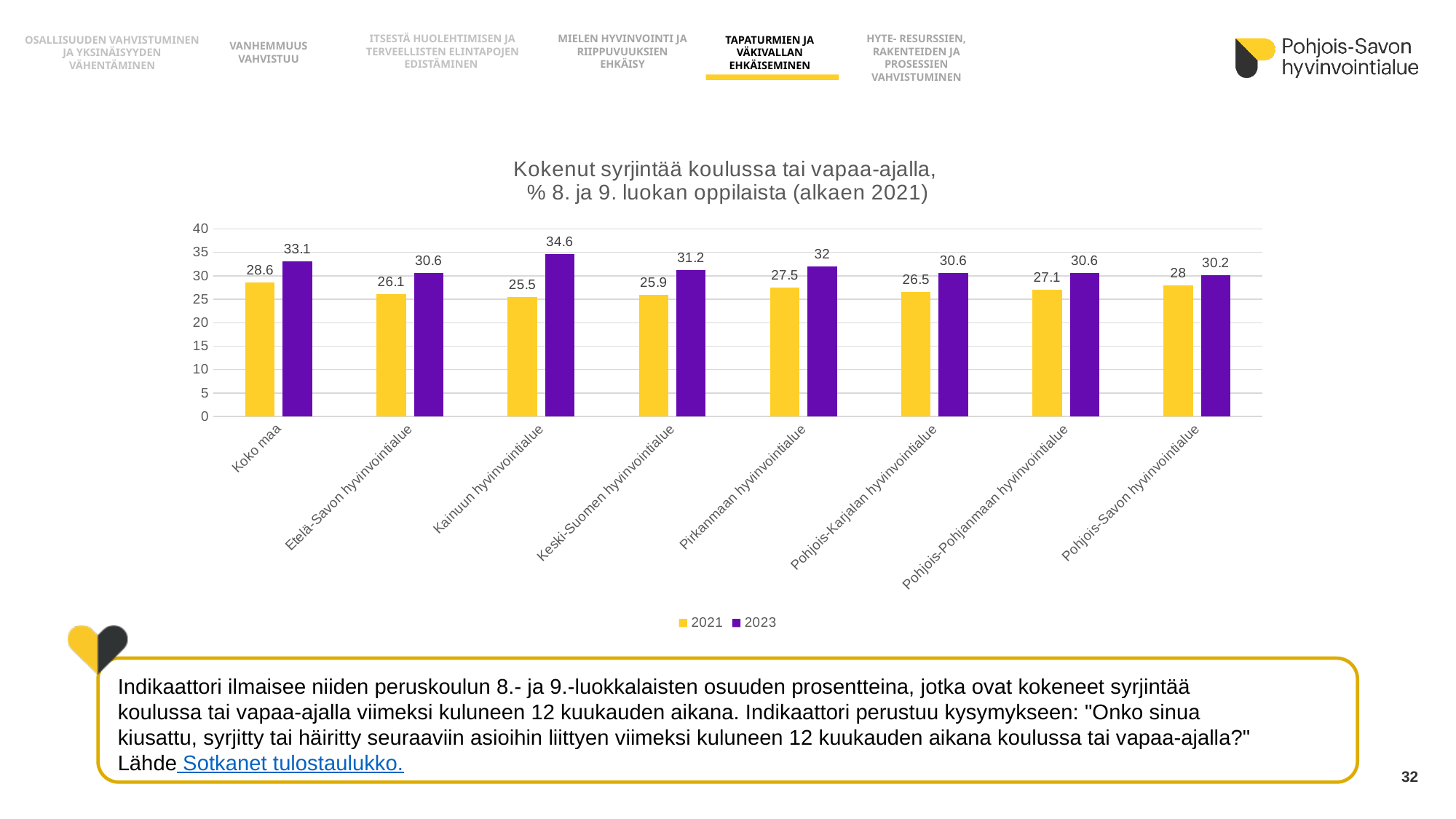
Is the 2023 value for Pirkanmaan hyvinvointialue greater or less than 30? greater What is the difference between the 2023 and 2021 values for Kainuun hyvinvointialue? 9.1 What is the difference between the 2023 values for Koko maa and Pohjois-Savon hyvinvointialue? 2.9 Which is larger: the 2021 value for Pirkanmaan hyvinvointialue or the 2021 value for Pohjois-Karjalan hyvinvointialue? Pirkanmaan hyvinvointialue Which category has the lowest 2021 value? Kainuun hyvinvointialue Which category has the highest 2023 value? Kainuun hyvinvointialue How many series does the legend list? 2 What is the 2021 value for Koko maa? 28.6 What is the 2021 value for Pohjois-Savon hyvinvointialue? 28 What kind of chart is shown on the slide? Bar chart What is the 2023 value for Kainuun hyvinvointialue? 34.6 How many categories are shown on the x axis? 8